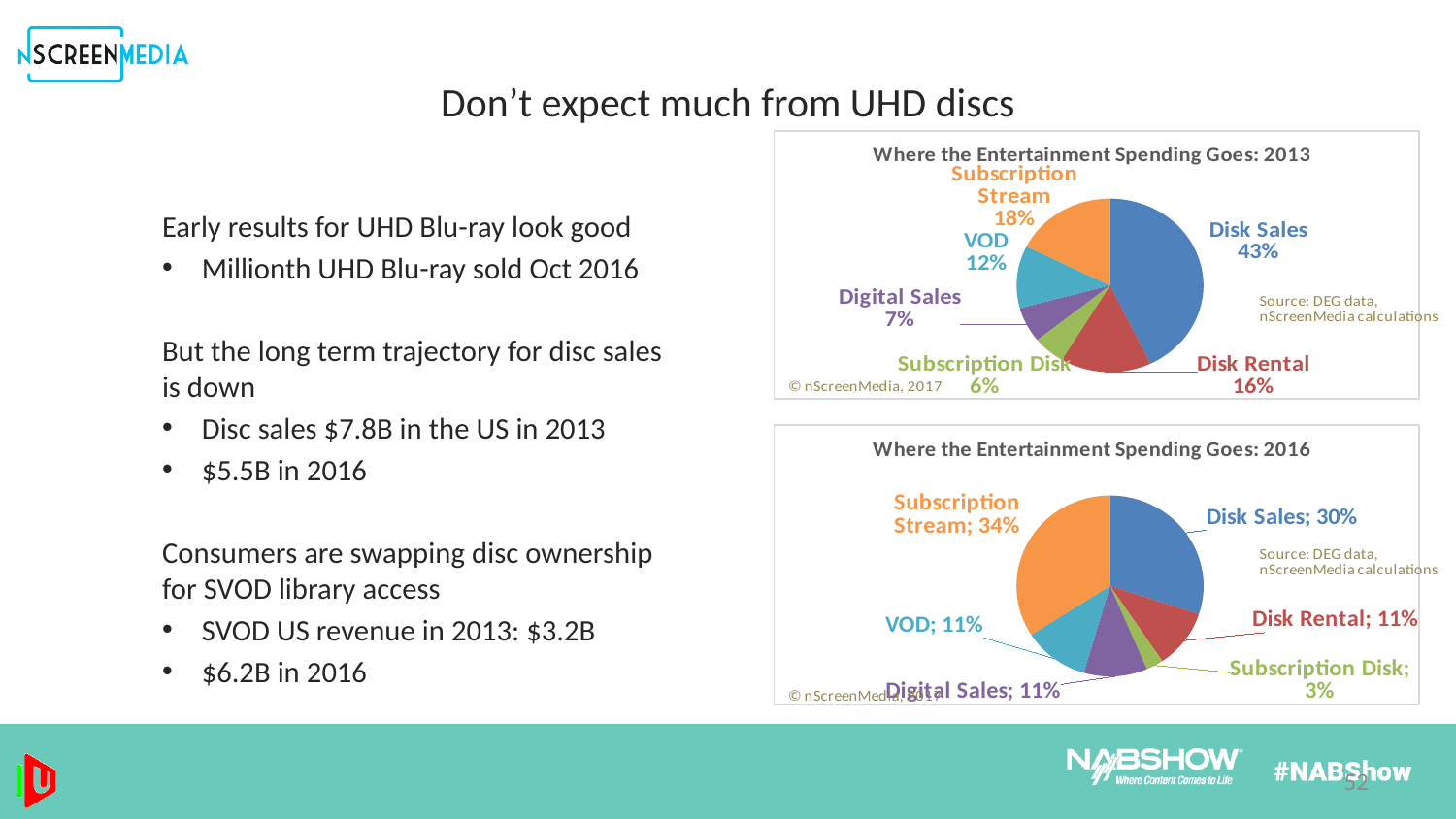
In the 'Where the Entertainment Spending Goes: 2016' chart, which category has the largest share? Subscription Stream In the 'Where the Entertainment Spending Goes: 2013' chart, what share does Subscription Stream have? 18% What source is cited for the data in the 'Where the Entertainment Spending Goes: 2013' chart? DEG data, nScreenMedia calculations In the 'Where the Entertainment Spending Goes: 2016' chart, what share does Subscription Stream have? 34% In the 'Where the Entertainment Spending Goes: 2016' chart, what is the difference between the Subscription Stream share and the Disk Sales share? 4% In the 'Where the Entertainment Spending Goes: 2013' chart, what is the difference between the Disk Sales share and the Disk Rental share? 27% What type of chart is the 'Where the Entertainment Spending Goes: 2016' chart? Pie chart In the 'Where the Entertainment Spending Goes: 2013' chart, which category has the smallest share? Subscription Disk In the 'Where the Entertainment Spending Goes: 2013' chart, how many categories are shown? 6 In the 'Where the Entertainment Spending Goes: 2016' chart, what share does Subscription Disk have? 3% In the 'Where the Entertainment Spending Goes: 2013' chart, what share does Disk Sales have? 43% In the 'Where the Entertainment Spending Goes: 2016' chart, which is larger, Disk Sales or Disk Rental? Disk Sales